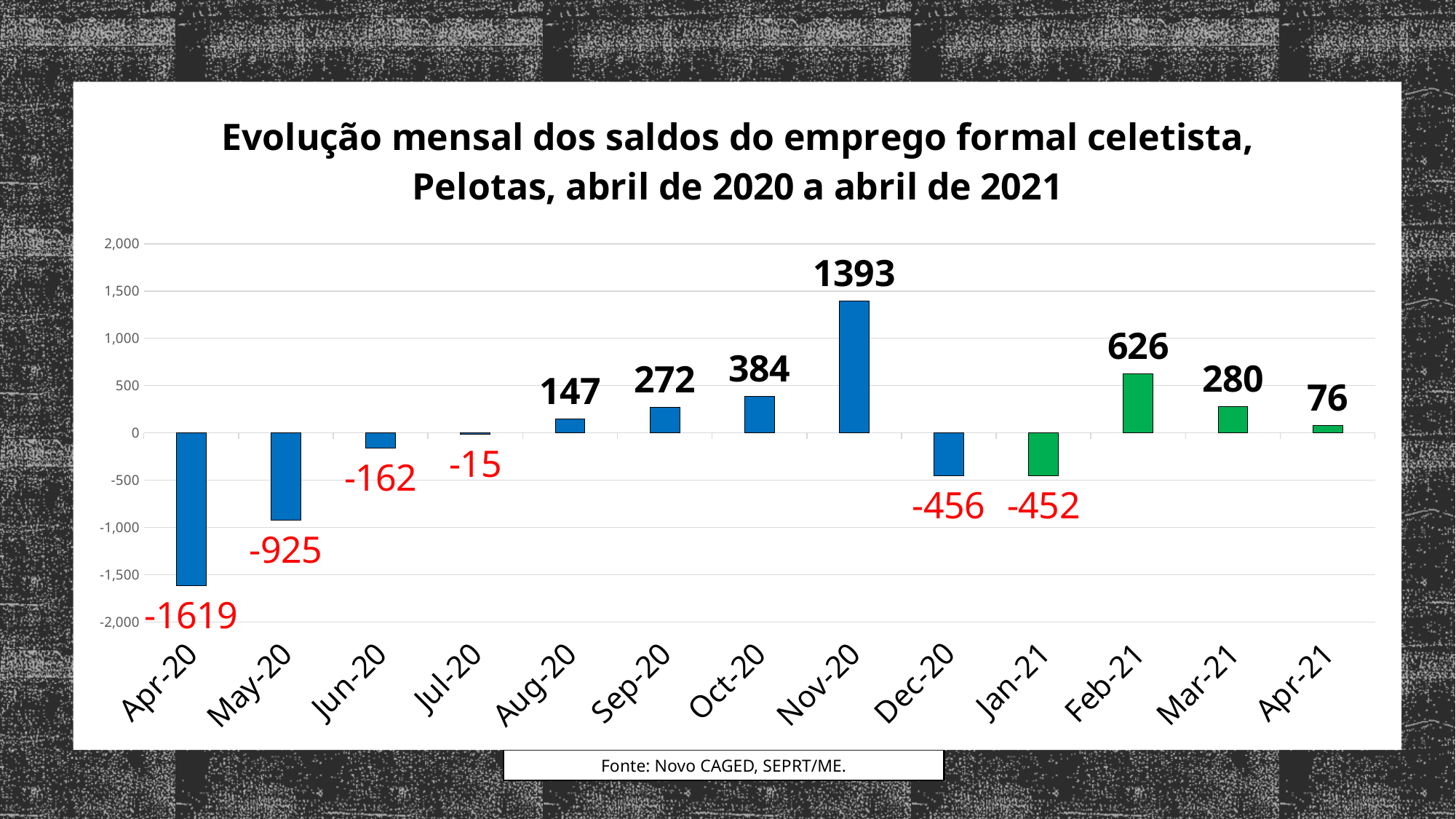
What kind of chart is this? Bar chart What is the value for Feb-21? 626 What is the value for Apr-20? -1619 Which month has the highest value? Nov-20 What is the difference between the values for Nov-20 and Oct-20? 1009 Which is larger, the value for Sep-20 or the value for Mar-21? Mar-21 What is the value for Nov-20? 1393 What is the source cited below the chart? Novo CAGED, SEPRT/ME. Which month has the lowest value? Apr-20 How many months are shown on the x axis? 13 Do the values rise or fall from Apr-20 to Nov-20? Rise What is the value for Jul-20? -15